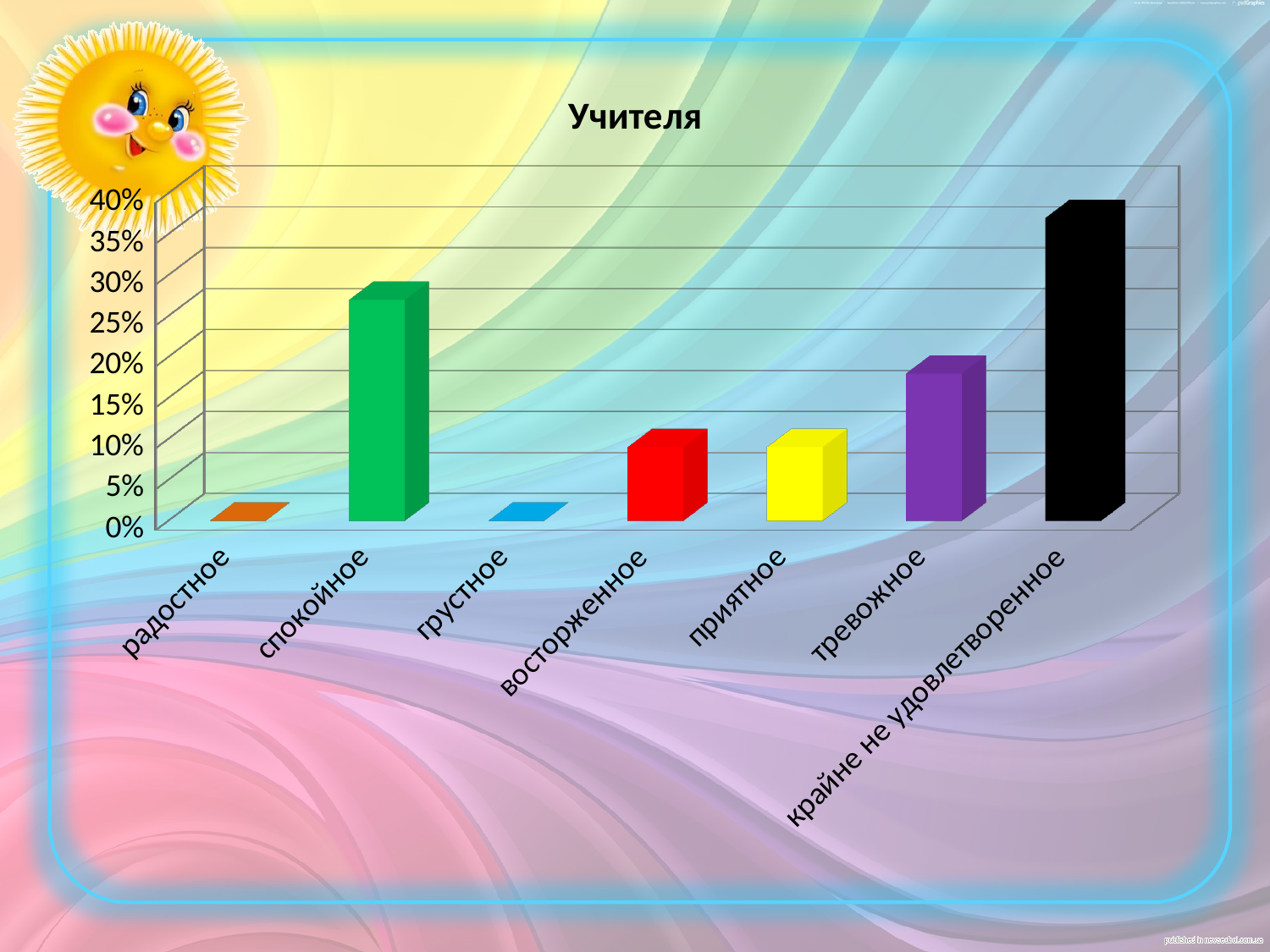
Is the value for тревожное greater or less than 20%? less Which is larger, the value for крайне не удовлетворенное or the value for спокойное? крайне не удовлетворенное Which is larger, the value for спокойное or the value for тревожное? спокойное Is the value for радостное greater or less than 5%? less Is the value for крайне не удовлетворенное greater or less than 35%? greater What is the title of the chart? Учителя Which category has the highest value in the chart? крайне не удовлетворенное What kind of chart is shown on the slide? bar chart Which category is represented by the black bar? крайне не удовлетворенное How many categories are shown on the x axis of the chart? 7